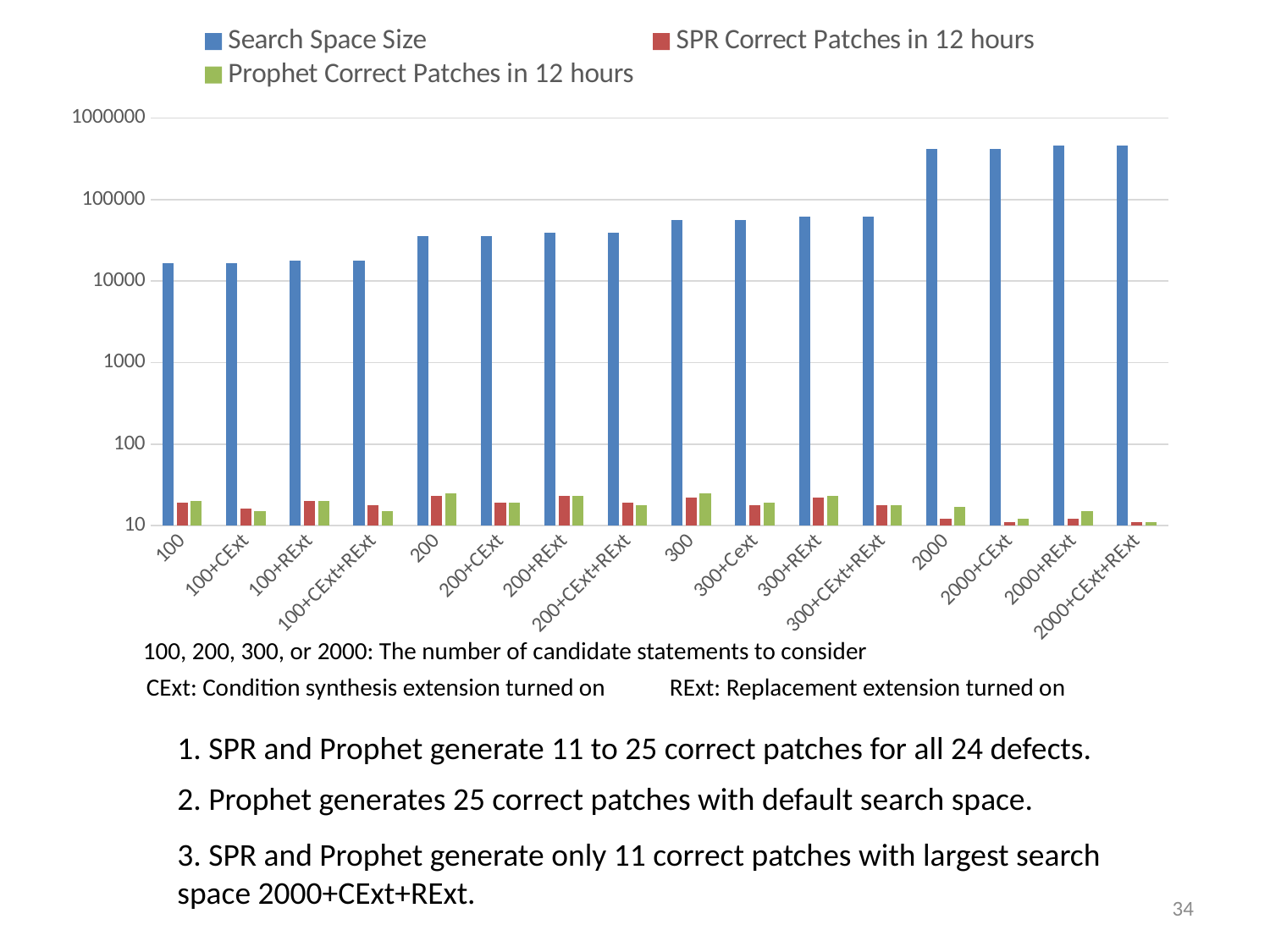
What colour are the Search Space Size bars? blue Which series is shown in green in the legend? Prophet Correct Patches in 12 hours Is the Search Space Size for 2000 greater or less than 100000? greater What kind of chart is shown on the slide? bar chart Which is larger, the Prophet Correct Patches in 12 hours value for 200 or for 2000+CExt+RExt? 200 How many series does the legend list? 3 Which is larger, the Search Space Size for 2000 or for 100? 2000 Is the Search Space Size for 100 greater or less than 10000? greater Does the Search Space Size generally rise or fall from left to right along the x axis? rise Is the Search Space Size for 200 greater or less than 100000? less How many categories are shown on the x axis? 16